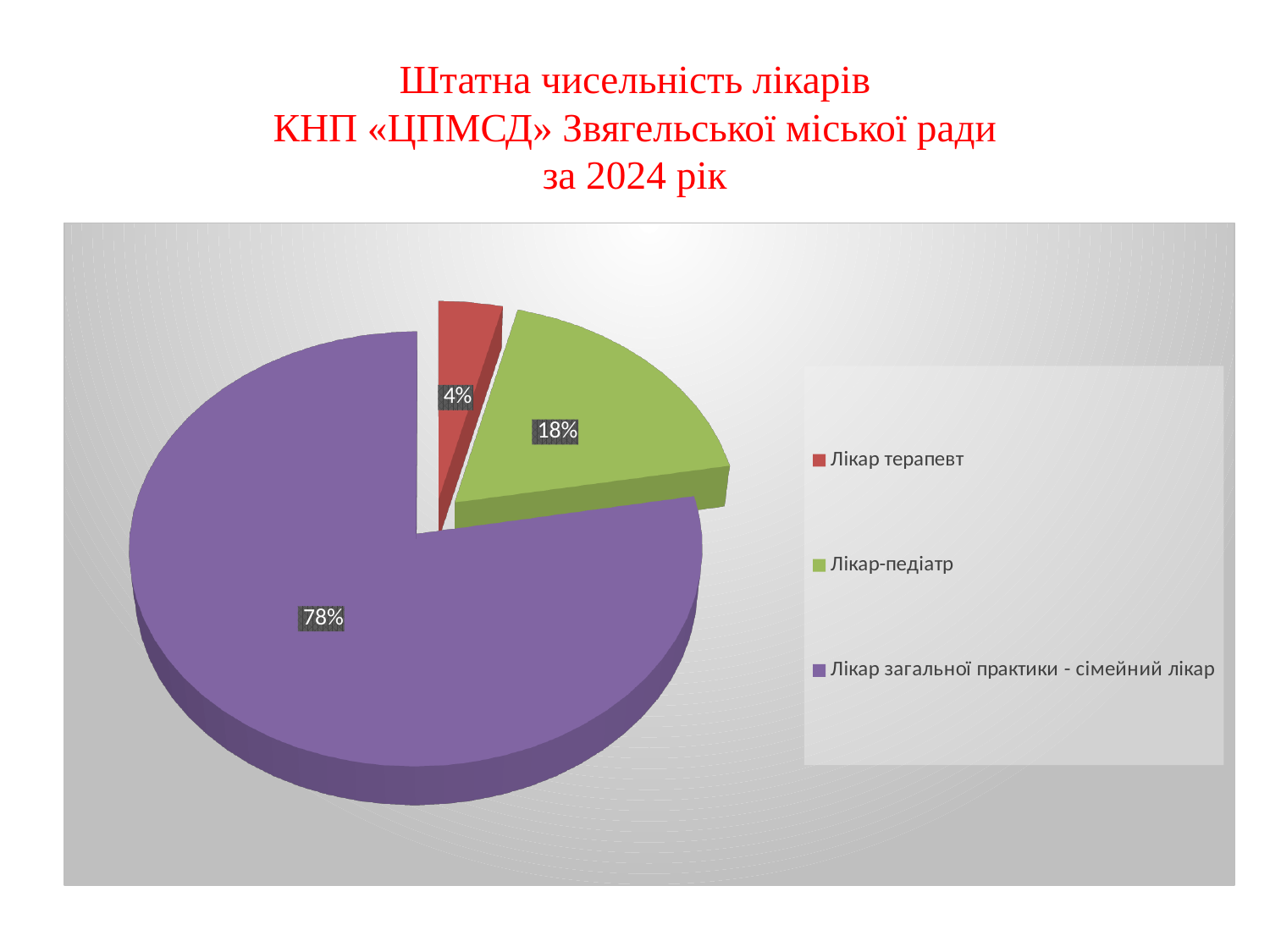
Which category has the smallest slice of the pie? Лікар терапевт What share of the pie does Лікар-педіатр have? 18% What share of the pie does Лікар загальної практики - сімейний лікар have? 78% How many categories does the pie chart show? 3 What is the difference in percentage points between Лікар загальної практики - сімейний лікар and Лікар-педіатр? 60 Which category has the largest slice of the pie? Лікар загальної практики - сімейний лікар What share of the pie does Лікар терапевт have? 4% Which is larger, the share for Лікар-педіатр or the share for Лікар терапевт? Лікар-педіатр Which year does the chart title refer to? 2024 What kind of chart is shown on the slide? Pie chart What colour is the slice for Лікар-педіатр? Green What is the difference in percentage points between Лікар-педіатр and Лікар терапевт? 14